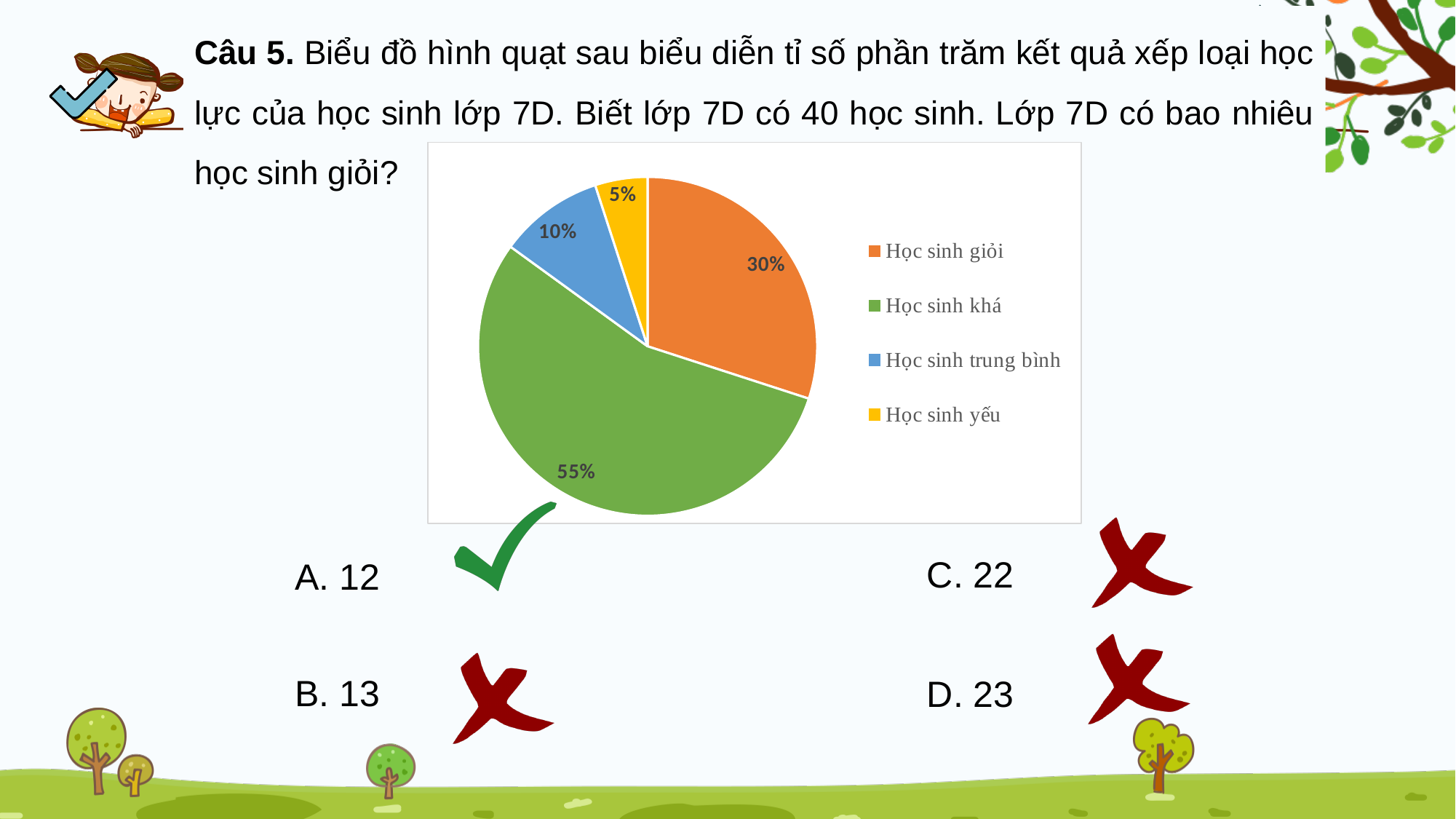
Which legend entry is shown in blue? Học sinh trung bình Which slice is larger, Học sinh trung bình or Học sinh yếu? Học sinh trung bình What percentage of the pie is labelled for Học sinh yếu? 5% What is the difference in percentage points between Học sinh khá and Học sinh giỏi? 25 What percentage of the pie is labelled for Học sinh khá? 55% What colour is the slice for Học sinh giỏi? orange Which category has the smallest slice of the pie? Học sinh yếu What percentage of the pie is labelled for Học sinh giỏi? 30% What percentage of the pie is labelled for Học sinh trung bình? 10% How many categories does the pie chart show? 4 What kind of chart is shown on the slide? pie chart Which category has the largest slice of the pie? Học sinh khá